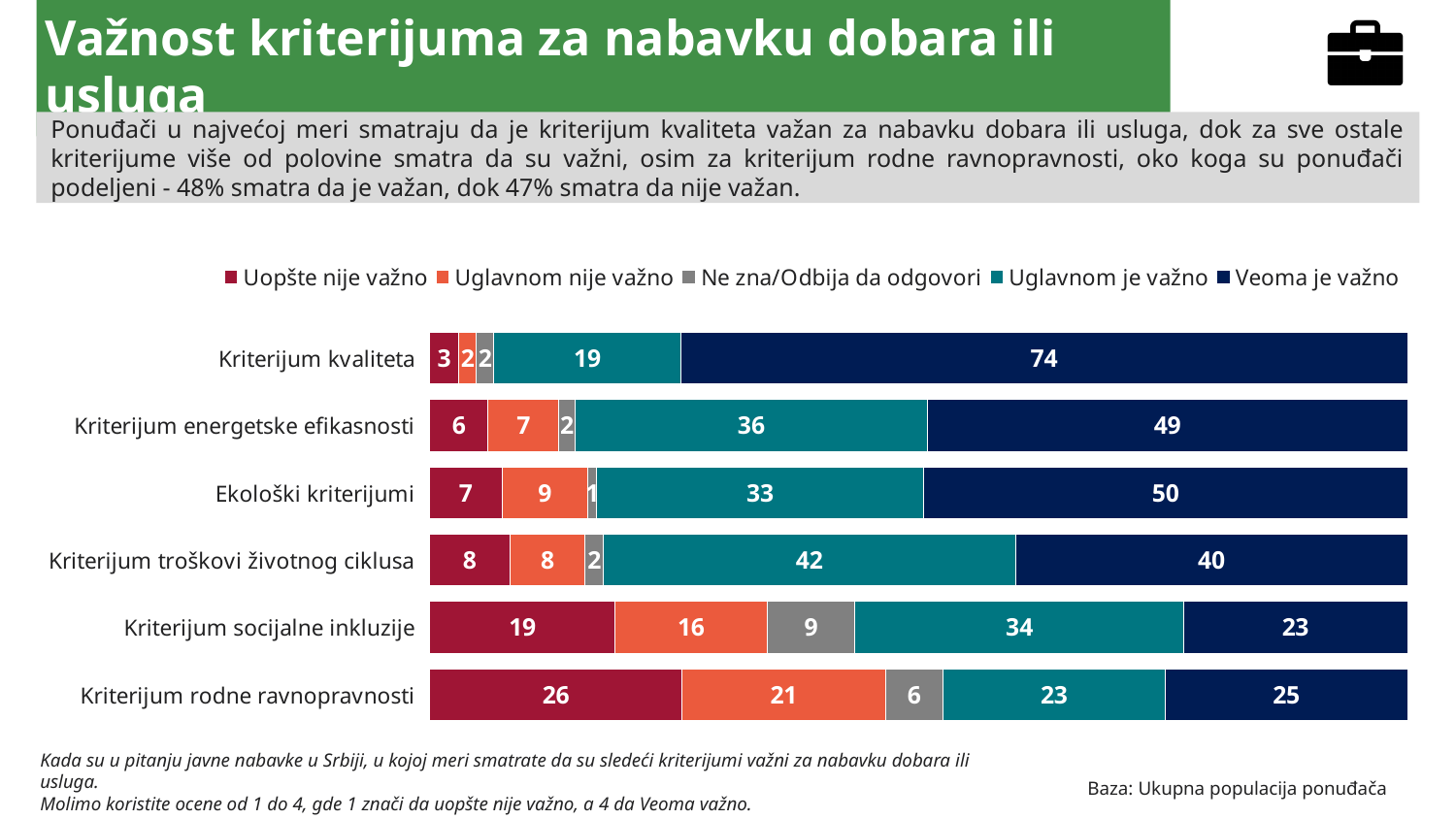
Which category has the lowest value for 'Uopšte nije važno'? Kriterijum kvaliteta Which is larger: 'Uglavnom nije važno' for Kriterijum rodne ravnopravnosti or for Kriterijum socijalne inkluzije? Kriterijum rodne ravnopravnosti What is the difference between the 'Veoma je važno' values for Ekološki kriterijumi and Kriterijum socijalne inkluzije? 27 What kind of chart is shown on the slide? stacked bar chart What is the value of 'Veoma je važno' for Kriterijum kvaliteta? 74 What is the value of 'Uglavnom je važno' for Kriterijum troškovi životnog ciklusa? 42 What is the value of 'Uopšte nije važno' for Kriterijum rodne ravnopravnosti? 26 What is the total of the stacked bar for Kriterijum energetske efikasnosti? 100 Which category has the highest value for 'Veoma je važno'? Kriterijum kvaliteta What is the value of 'Ne zna/Odbija da odgovori' for Kriterijum socijalne inkluzije? 9 How many categories (criteria) are shown in the chart? 6 How many series does the legend list? 5